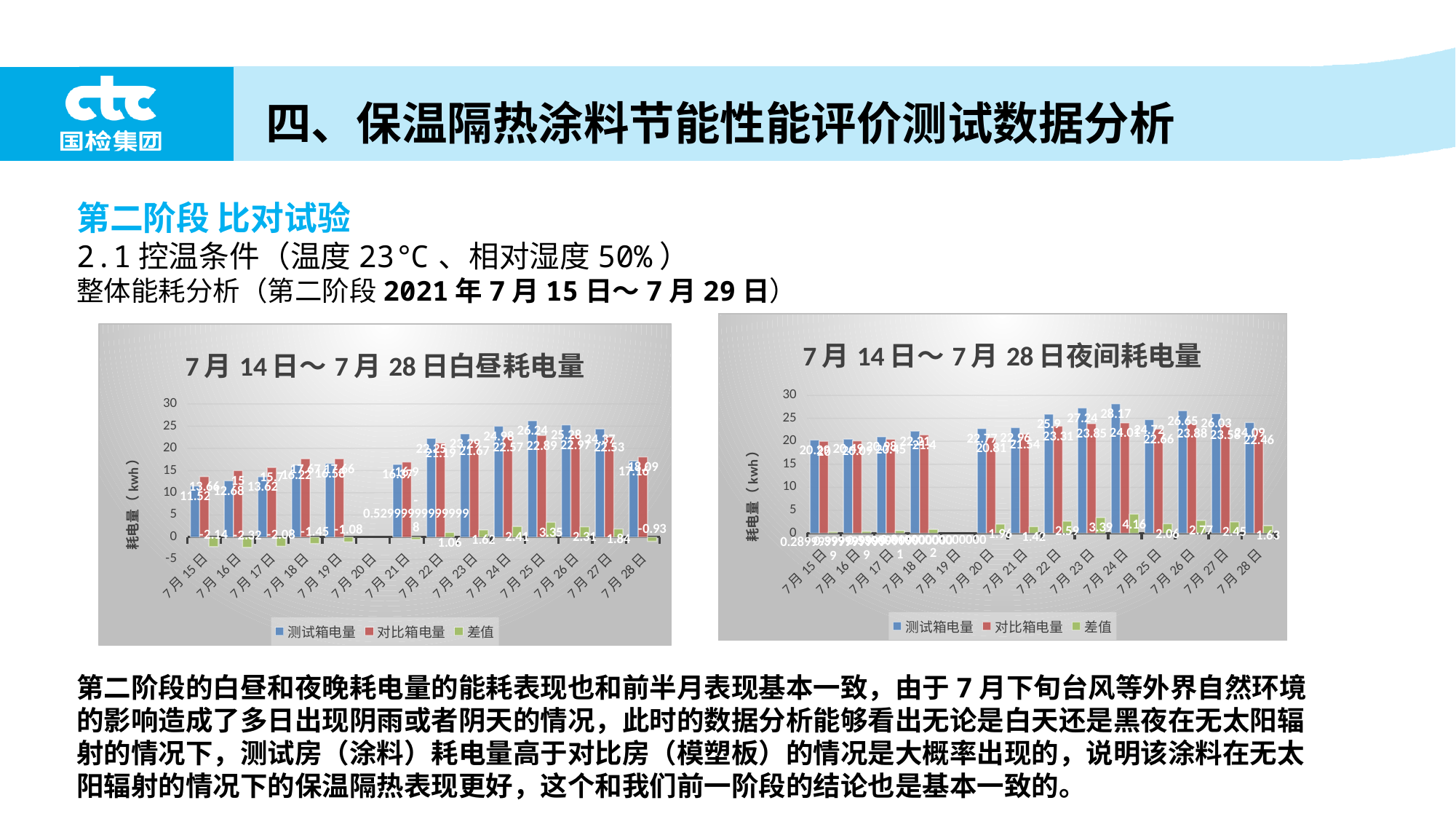
What are the three legend entries of the right chart (夜间耗电量)? 测试箱电量, 对比箱电量, 差值 In the right chart (夜间耗电量), is the 测试箱电量 value on 7月24日 greater or less than 25? greater How many dates are shown on the x axis of the left chart (白昼耗电量)? 14 In the left chart (白昼耗电量), which is larger on 7月15日, 测试箱电量 or 对比箱电量? 对比箱电量 In the right chart (夜间耗电量), on which date is the 差值 highest? 7月24日 In the left chart (白昼耗电量), what is the 测试箱电量 value on 7月25日? 26.24 How many series does the legend of the right chart (7月14日～7月28日夜间耗电量) list? 3 In the left chart (白昼耗电量), on which date is 测试箱电量 highest? 7月25日 In the right chart (夜间耗电量), what is the 测试箱电量 value on 7月24日? 28.17 What kind of chart is the left chart titled 7月14日～7月28日白昼耗电量? bar chart In the left chart (白昼耗电量), what is the 差值 value on 7月15日? -2.14 In the left chart (白昼耗电量), what is the difference between 测试箱电量 (26.24) and 对比箱电量 (22.89) on 7月25日? 3.35